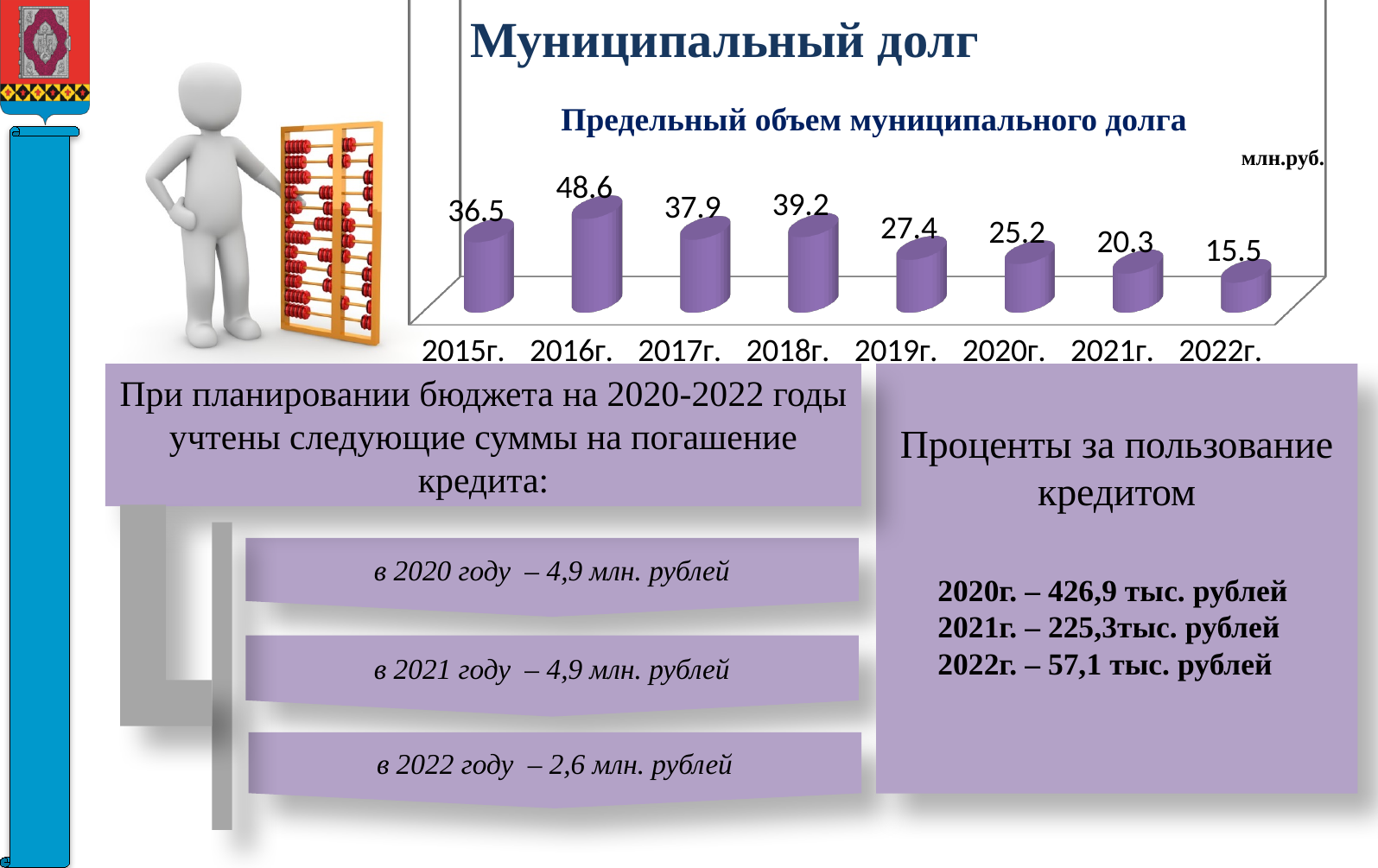
What is the difference between the values for 2018г. and 2017г. in the chart 'Предельный объем муниципального долга'? 1.3 What is the difference between the values for 2016г. and 2022г. in the chart 'Предельный объем муниципального долга'? 33.1 Which year has the highest value in the chart 'Предельный объем муниципального долга'? 2016г. Which year has the lowest value in the chart 'Предельный объем муниципального долга'? 2022г. How many years (categories) are shown in the chart 'Предельный объем муниципального долга'? 8 What kind of chart is 'Предельный объем муниципального долга'? bar chart What unit is indicated for the values in the chart 'Предельный объем муниципального долга'? млн.руб. What is the value for 2019г. in the chart 'Предельный объем муниципального долга'? 27.4 Which is larger in the chart 'Предельный объем муниципального долга': the value for 2015г. or the value for 2017г.? 2017г. What is the value for 2022г. in the chart 'Предельный объем муниципального долга'? 15.5 What is the value for 2016г. in the chart 'Предельный объем муниципального долга'? 48.6 Do the values in the chart 'Предельный объем муниципального долга' rise or fall from 2018г. to 2022г.? fall